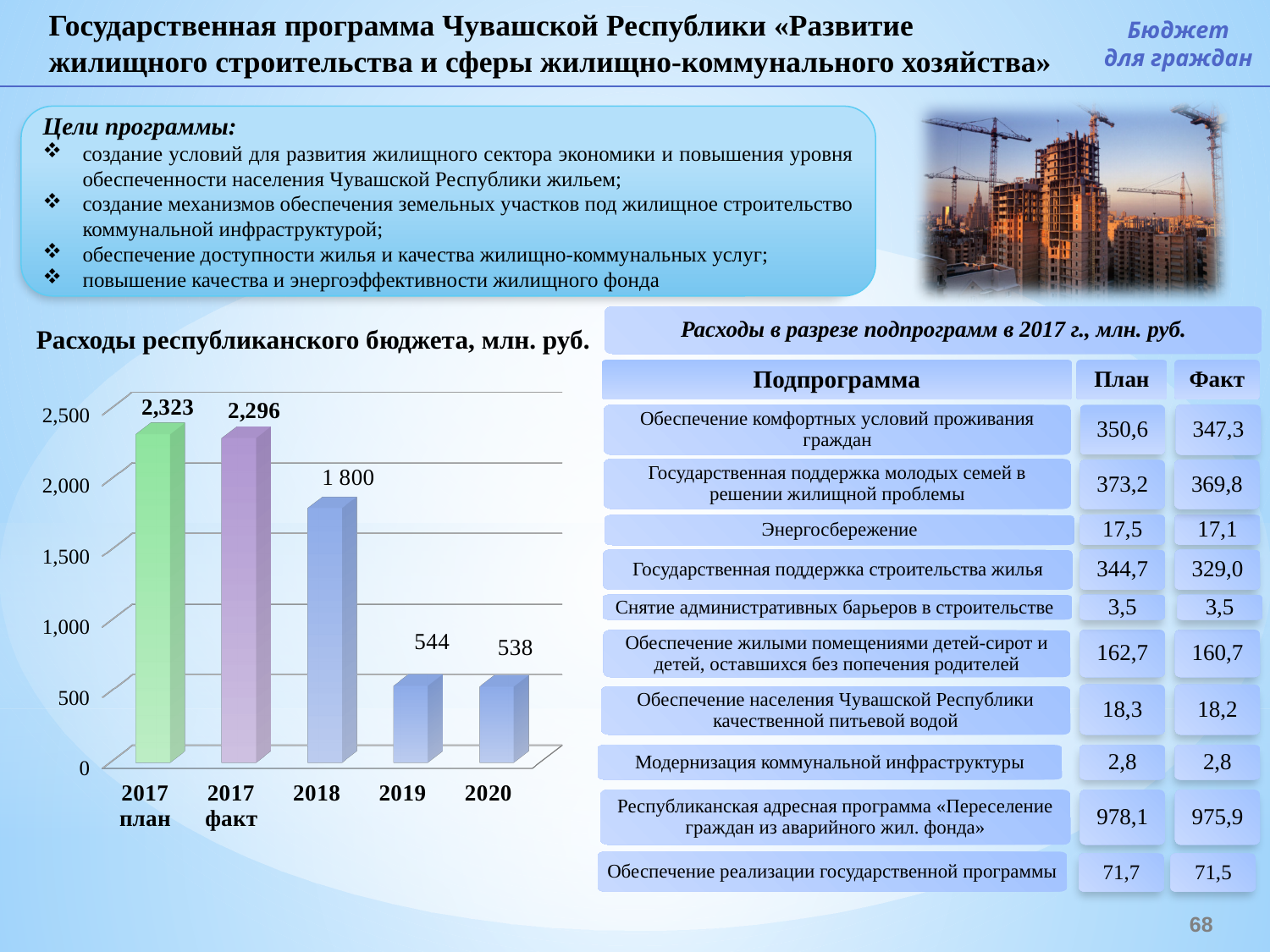
In the chart 'Расходы республиканского бюджета, млн. руб.', which is larger: the value for 2018 or the value for 2019? 2018 What is the difference between the 2017 план and 2017 факт values in the chart 'Расходы республиканского бюджета, млн. руб.'? 27 Which category has the highest value in the chart 'Расходы республиканского бюджета, млн. руб.'? 2017 план What is the value for 2017 факт in the chart 'Расходы республиканского бюджета, млн. руб.'? 2,296 Is the value for 2019 in the chart 'Расходы республиканского бюджета, млн. руб.' greater or less than 1,000? less How many categories are shown in the chart 'Расходы республиканского бюджета, млн. руб.'? 5 Which category has the lowest value in the chart 'Расходы республиканского бюджета, млн. руб.'? 2020 What kind of chart is 'Расходы республиканского бюджета, млн. руб.'? bar chart What is the value for 2018 in the chart 'Расходы республиканского бюджета, млн. руб.'? 1 800 What is the value for 2020 in the chart 'Расходы республиканского бюджета, млн. руб.'? 538 What is the difference between the 2018 and 2019 values in the chart 'Расходы республиканского бюджета, млн. руб.'? 1 256 What is the value for 2017 план in the chart 'Расходы республиканского бюджета, млн. руб.'? 2,323